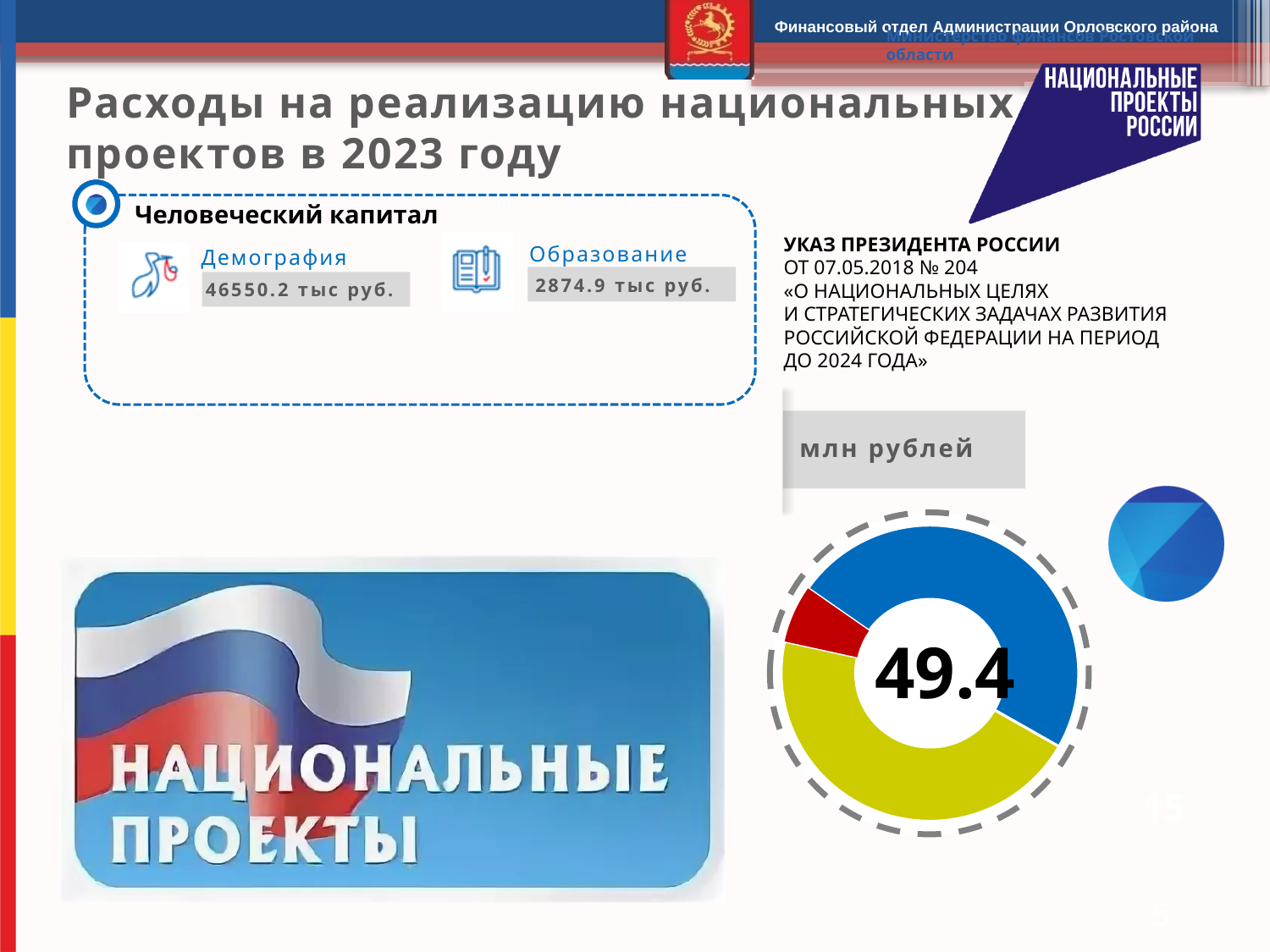
What unit is shown in the label above the doughnut chart? млн рублей In the doughnut chart, which is larger: the red slice or the yellow slice? the yellow slice Which slice of the doughnut chart is the smallest? the red slice What colours are the slices of the doughnut chart? blue, yellow and red How many slices does the doughnut chart on the right contain? 3 What value is printed in the centre of the doughnut chart? 49.4 What kind of chart is shown on the right side of the slide? doughnut (pie) chart In the doughnut chart, which is larger: the red slice or the blue slice? the blue slice